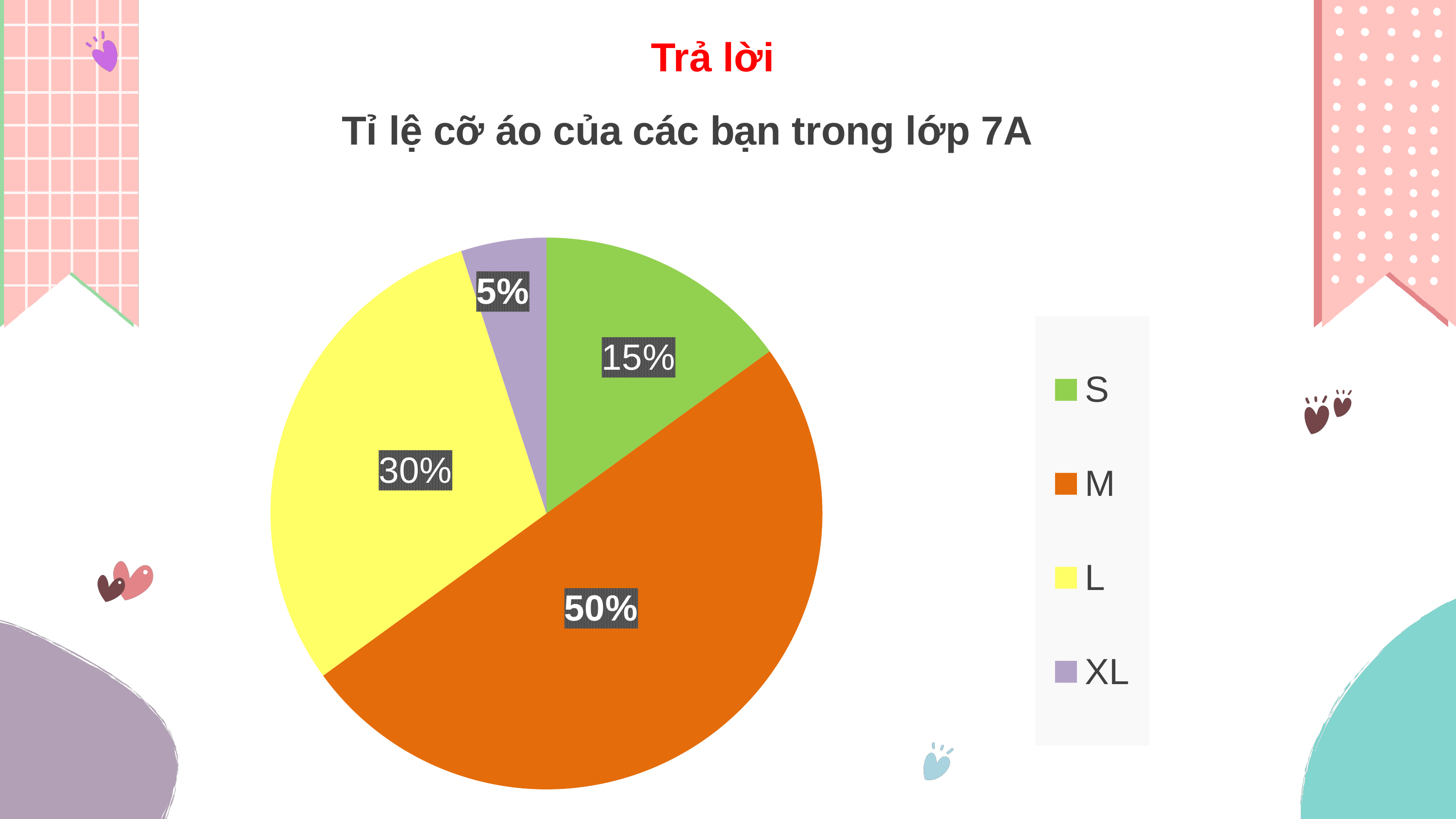
What percentage of the pie chart is size XL? 5% What type of chart is shown on the slide? pie chart What is the difference in percentage points between size M and size L? 20 Which shirt size has the smallest share of the pie chart? XL What colour represents size L in the pie chart? yellow Which shirt size has the largest share of the pie chart? M What percentage of the pie chart is size M? 50% What is the difference in percentage points between size S and size XL? 10 How many shirt sizes are shown in the pie chart? 4 Which has a larger share, size S or size L? L What percentage of the pie chart is size S? 15% What percentage of the pie chart is size L? 30%